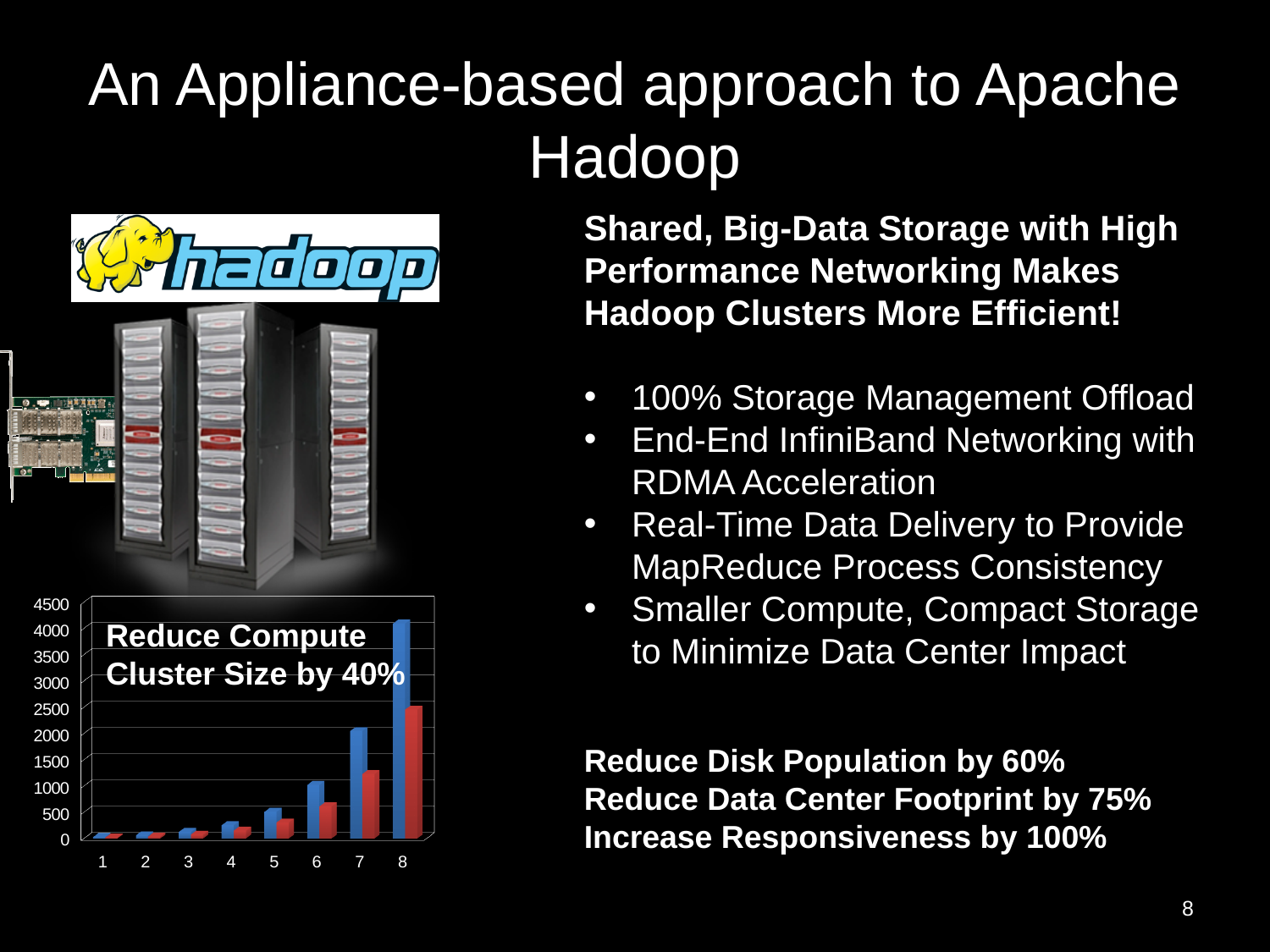
In the bar chart, do the values rise or fall as you move from category 1 to category 8? rise In the bar chart, is the blue bar for category 7 greater or less than 1500? greater In the bar chart, which category has the tallest red bar? 8 In the bar chart, is the red bar for category 8 greater or less than 3000? less In the bar chart, is the blue bar for category 8 greater or less than 3500? greater In the bar chart, at category 8, which bar is taller, the blue one or the red one? blue What text is written over the bar chart? Reduce Compute Cluster Size by 40% In the bar chart, which category has the tallest blue bar? 8 How many differently coloured bar series are plotted in the bar chart? 2 What kind of chart is shown at the bottom left of the slide? bar chart What is the highest value labelled on the y axis of the bar chart? 4500 How many categories are shown on the x axis of the bar chart? 8